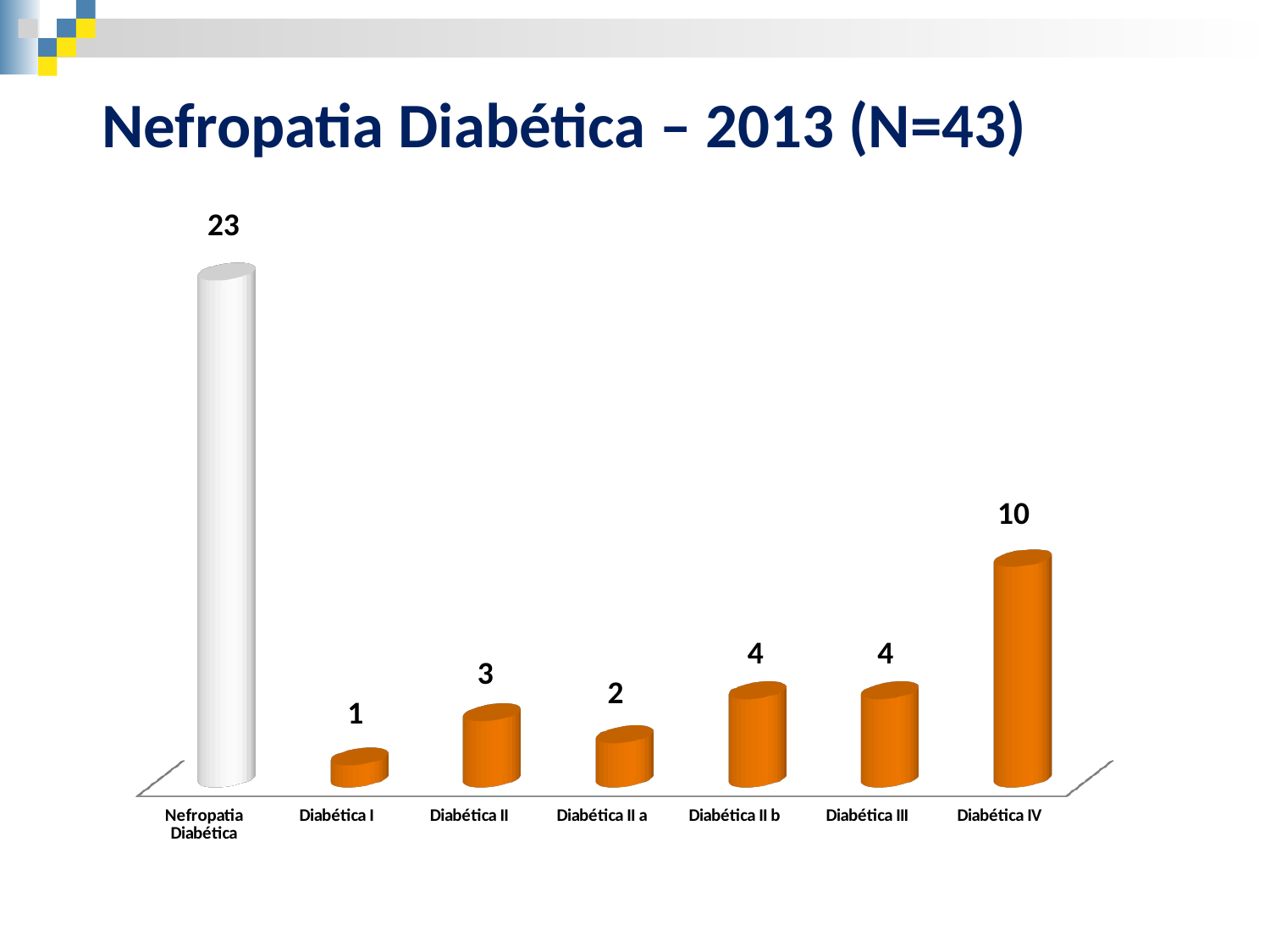
How many categories are shown on the chart? 7 Which is larger, the value for Diabética II or the value for Diabética II a? Diabética II What is the value for Diabética III? 4 What is the title of the slide? Nefropatia Diabética – 2013 (N=43) Which category has the lowest value? Diabética I Which category has the highest value? Nefropatia Diabética What is the value for Diabética II a? 2 What is the difference between the values for Nefropatia Diabética and Diabética IV? 13 What kind of chart is shown on the slide? Bar chart What is the value for Diabética IV? 10 What is the difference between the values for Diabética II and Diabética I? 2 What is the value for Nefropatia Diabética? 23